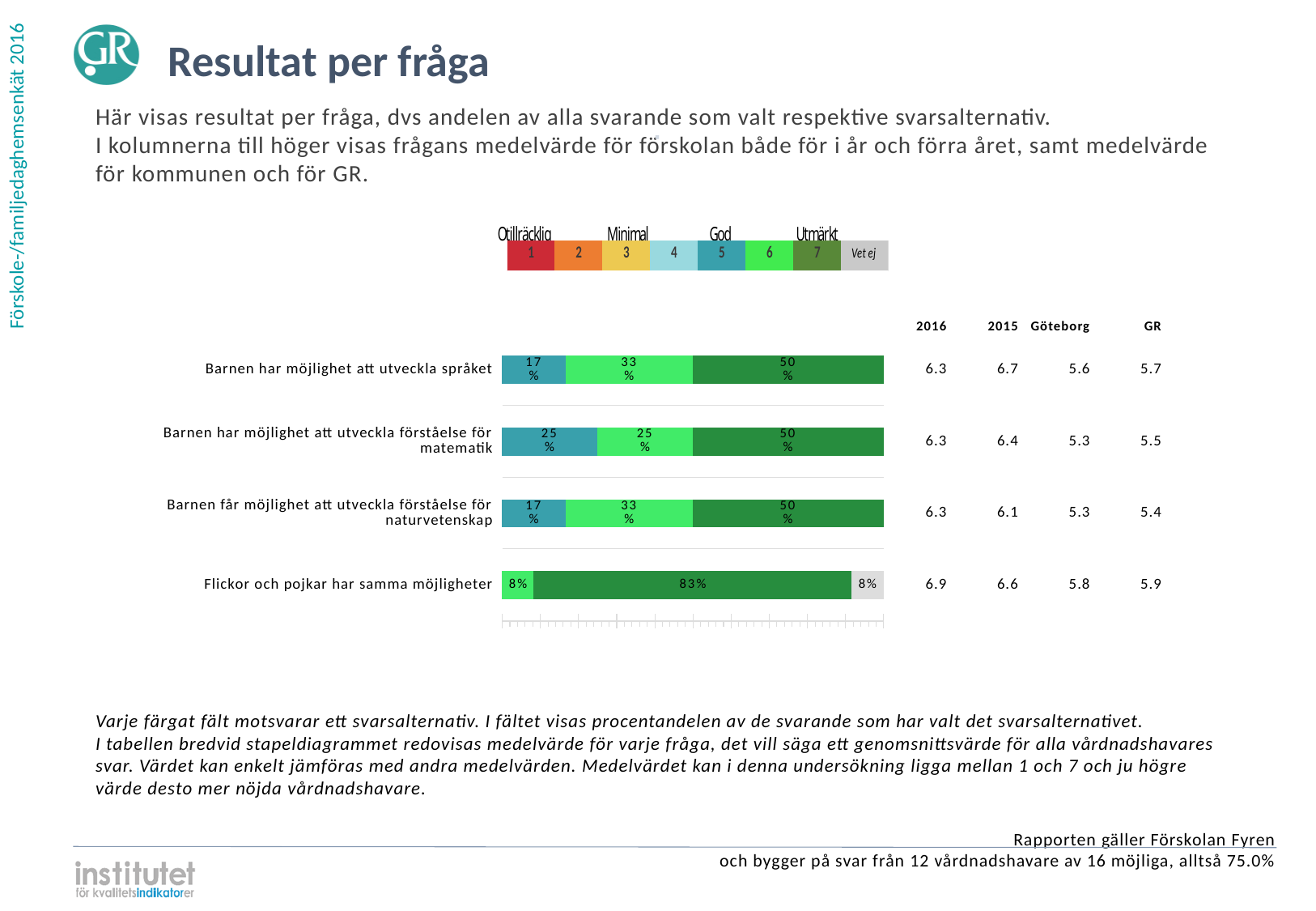
How many questions (categories) are plotted in the bar chart? 4 What is the difference between the answer 7 share and the answer 5 share for "Barnen får möjlighet att utveckla förståelse för naturvetenskap"? 33 percentage points What is the Göteborg mean value shown for "Barnen har möjlighet att utveckla språket"? 5.6 What percentage of respondents chose answer 6 (light green) for "Barnen har möjlighet att utveckla språket"? 33% For "Barnen har möjlighet att utveckla förståelse för matematik", which is larger: the share for answer 5 or the share for answer 7? Answer 7 What percentage of respondents answered "Vet ej" for "Flickor och pojkar har samma möjligheter"? 8% What percentage of respondents chose answer 5 (teal) for "Barnen har möjlighet att utveckla förståelse för matematik"? 25% What kind of chart is shown on the slide? Stacked bar chart What is the 2016 mean value shown for "Flickor och pojkar har samma möjligheter"? 6.9 Which question has the largest share of respondents choosing answer 7 (dark green)? Flickor och pojkar har samma möjligheter How many answer alternatives does the colour legend above the chart show, including "Vet ej"? 8 What percentage of respondents chose answer 7 (dark green) for "Flickor och pojkar har samma möjligheter"? 83%